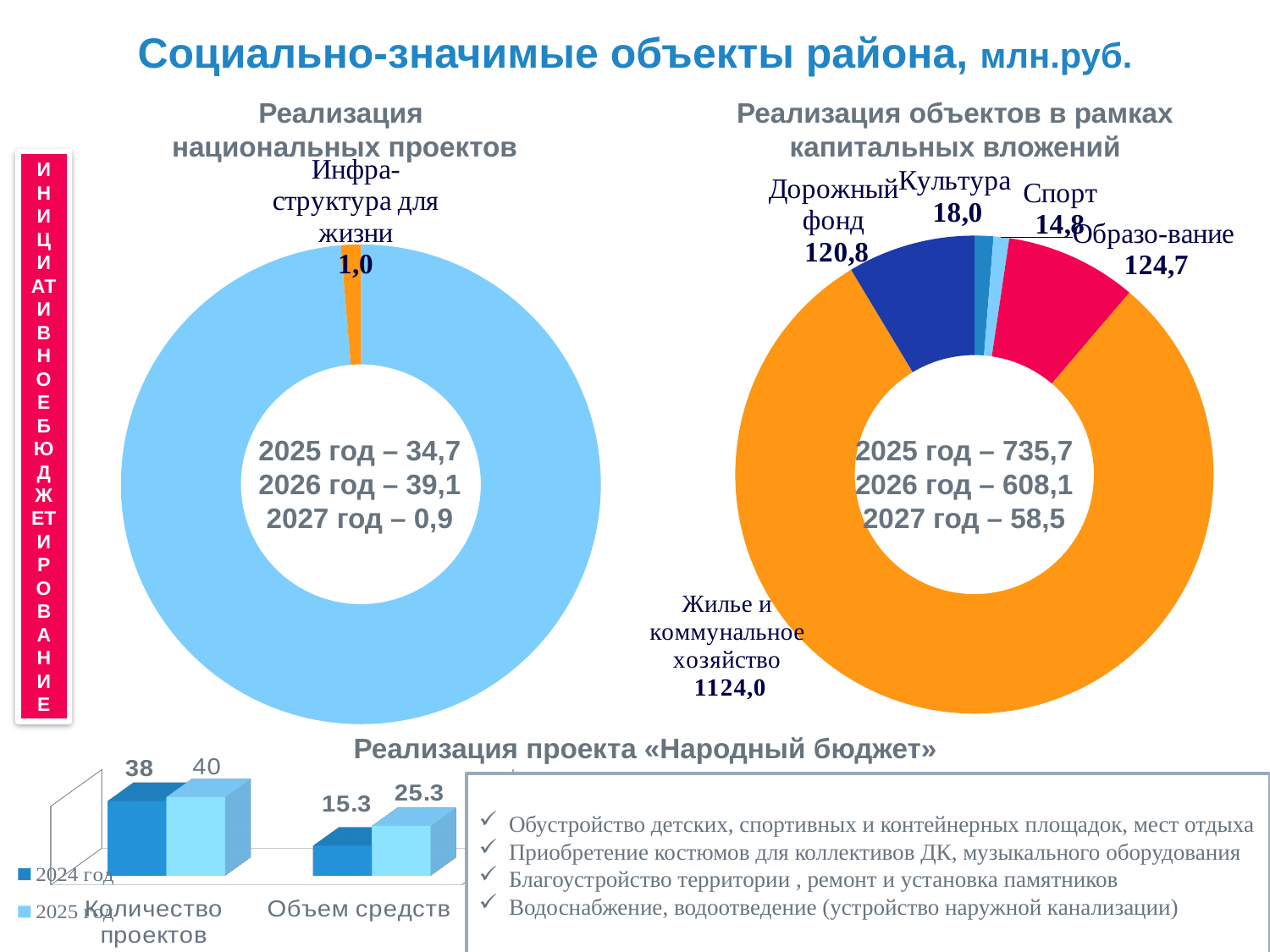
In the chart 'Реализация национальных проектов', what is the value for Инфраструктура для жизни? 1,0 In the chart 'Реализация объектов в рамках капитальных вложений', how many labelled categories are shown? 5 In the chart 'Реализация объектов в рамках капитальных вложений', what is the value for Жилье и коммунальное хозяйство? 1124,0 In the chart 'Реализация объектов в рамках капитальных вложений', what is the difference between Образование and Дорожный фонд? 3,9 In the chart 'Реализация объектов в рамках капитальных вложений', which category has the largest value? Жилье и коммунальное хозяйство In the chart 'Реализация объектов в рамках капитальных вложений', which category has the smallest value? Спорт In the chart 'Реализация проекта «Народный бюджет»', what is the value for Количество проектов in 2024 год? 38 What kind of chart is 'Реализация национальных проектов'? Doughnut chart In the chart 'Реализация объектов в рамках капитальных вложений', what is the value for Дорожный фонд? 120,8 In the chart 'Реализация проекта «Народный бюджет»', what is the value for Объем средств in 2025 год? 25.3 In the chart 'Реализация проекта «Народный бюджет»', how many series does the legend list? 2 In the chart 'Реализация проекта «Народный бюджет»', what is the difference between Объем средств in 2025 год and 2024 год? 10